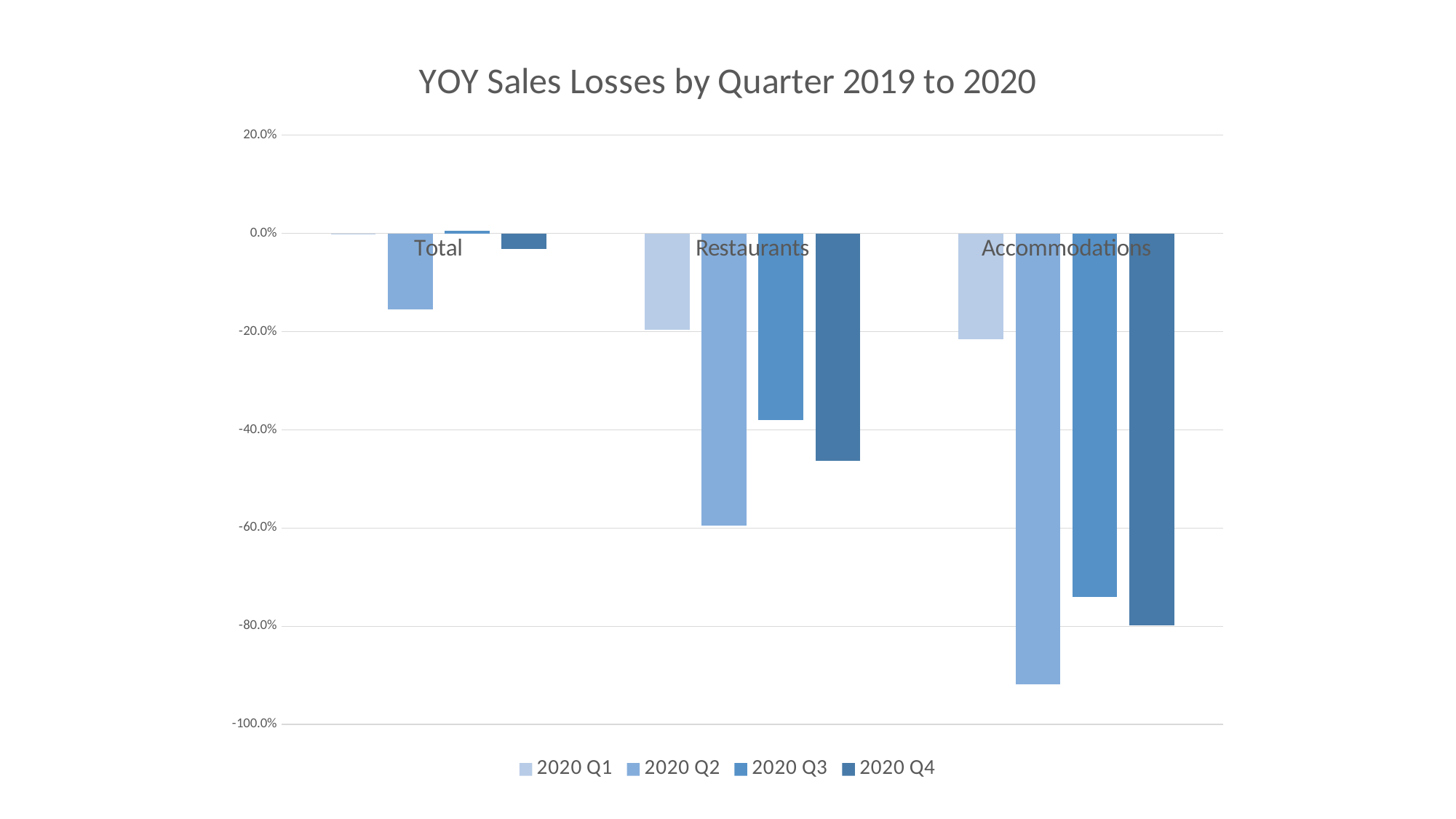
Is the value for Accommodations in 2020 Q2 greater or less than -80.0%? less What kind of chart is shown on the slide? bar chart How many categories are shown on the x axis? 3 What is the title of the chart? YOY Sales Losses by Quarter 2019 to 2020 Which quarter has the lowest value for Restaurants? 2020 Q2 Which series does the legend list last? 2020 Q4 Is the value for Accommodations in 2020 Q3 greater or less than -60.0%? less Which is lower, the 2020 Q4 value for Restaurants or the 2020 Q4 value for Accommodations? Accommodations How many series does the legend list? 4 Is the value for Total in 2020 Q2 greater or less than -20.0%? greater Which category has the lowest value in 2020 Q2? Accommodations